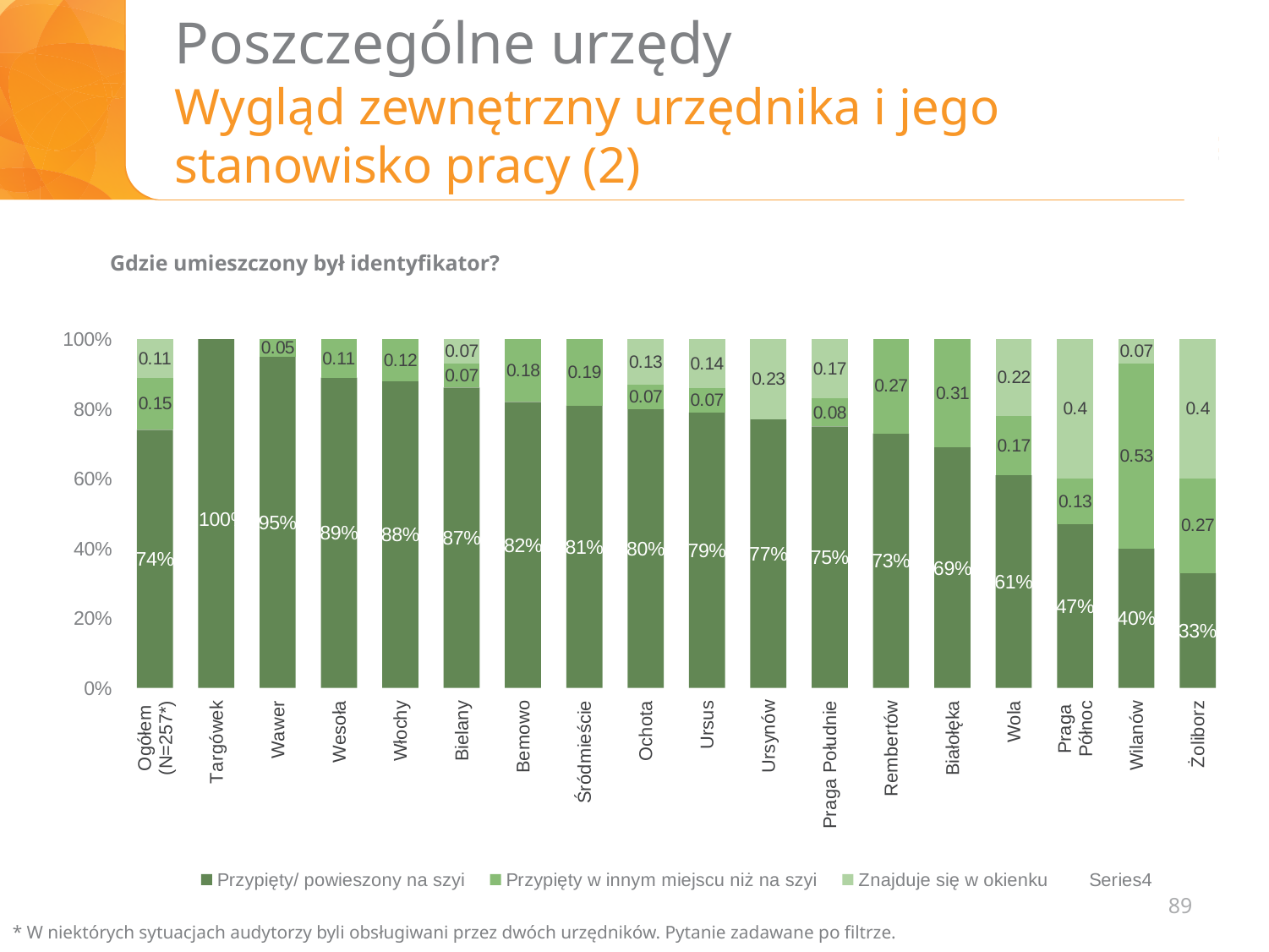
What is the value of "Przypięty/ powieszony na szyi" for Wola? 61% What is the value of "Przypięty/ powieszony na szyi" for Ogółem (N=257*)? 74% What question is the chart answering, as stated above it? Gdzie umieszczony był identyfikator? What is the difference between the "Przypięty/ powieszony na szyi" values for Wawer and Praga Północ? 48% What is the value of "Znajduje się w okienku" for Żoliborz? 0.4 Which has a larger "Przypięty/ powieszony na szyi" value, Bemowo or Rembertów? Bemowo Which district has the highest value for "Przypięty/ powieszony na szyi"? Targówek What kind of chart is shown on the slide? Stacked bar chart What is the value of "Przypięty w innym miejscu niż na szyi" for Wilanów? 0.53 How many categories are shown on the x axis? 18 How many series does the legend list? 4 Which district has the lowest value for "Przypięty/ powieszony na szyi"? Żoliborz